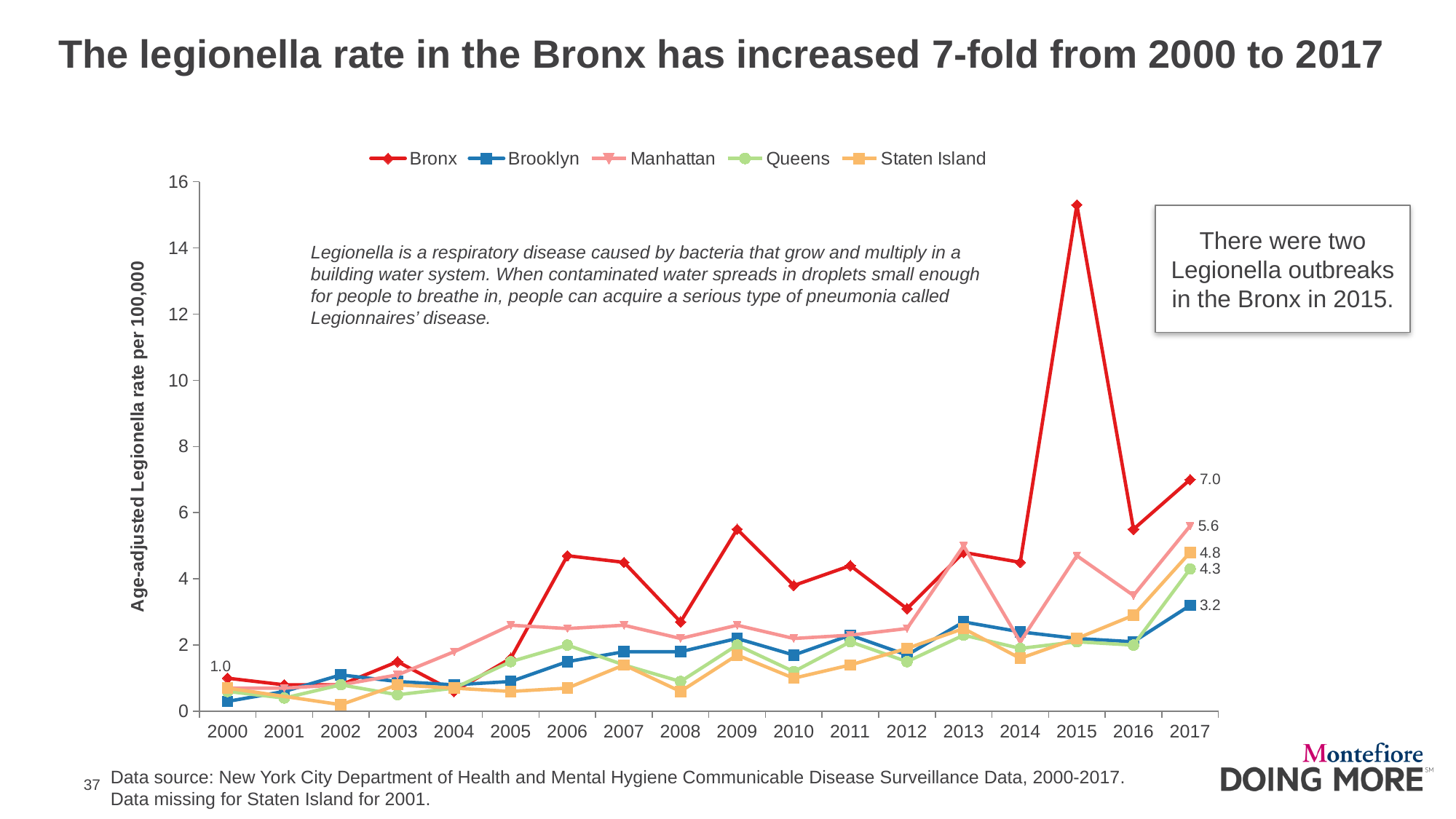
Which borough has the lowest Legionella rate in 2017? Brooklyn How many series does the legend list? 5 What kind of chart is shown on the slide? line chart What is the age-adjusted Legionella rate for the Bronx in 2000? 1.0 What is the age-adjusted Legionella rate for the Bronx in 2017? 7.0 By how much did the Bronx Legionella rate increase from 2000 to 2017? 6.0 How many years are shown on the x axis? 18 What is the Legionella rate for Manhattan in 2017? 5.6 In 2017, which is larger: the rate for Staten Island or the rate for Queens? Staten Island Which borough has the highest Legionella rate in 2017? Bronx What is the Legionella rate for Brooklyn in 2017? 3.2 Is the value for the Bronx in 2015 greater or less than 14? greater